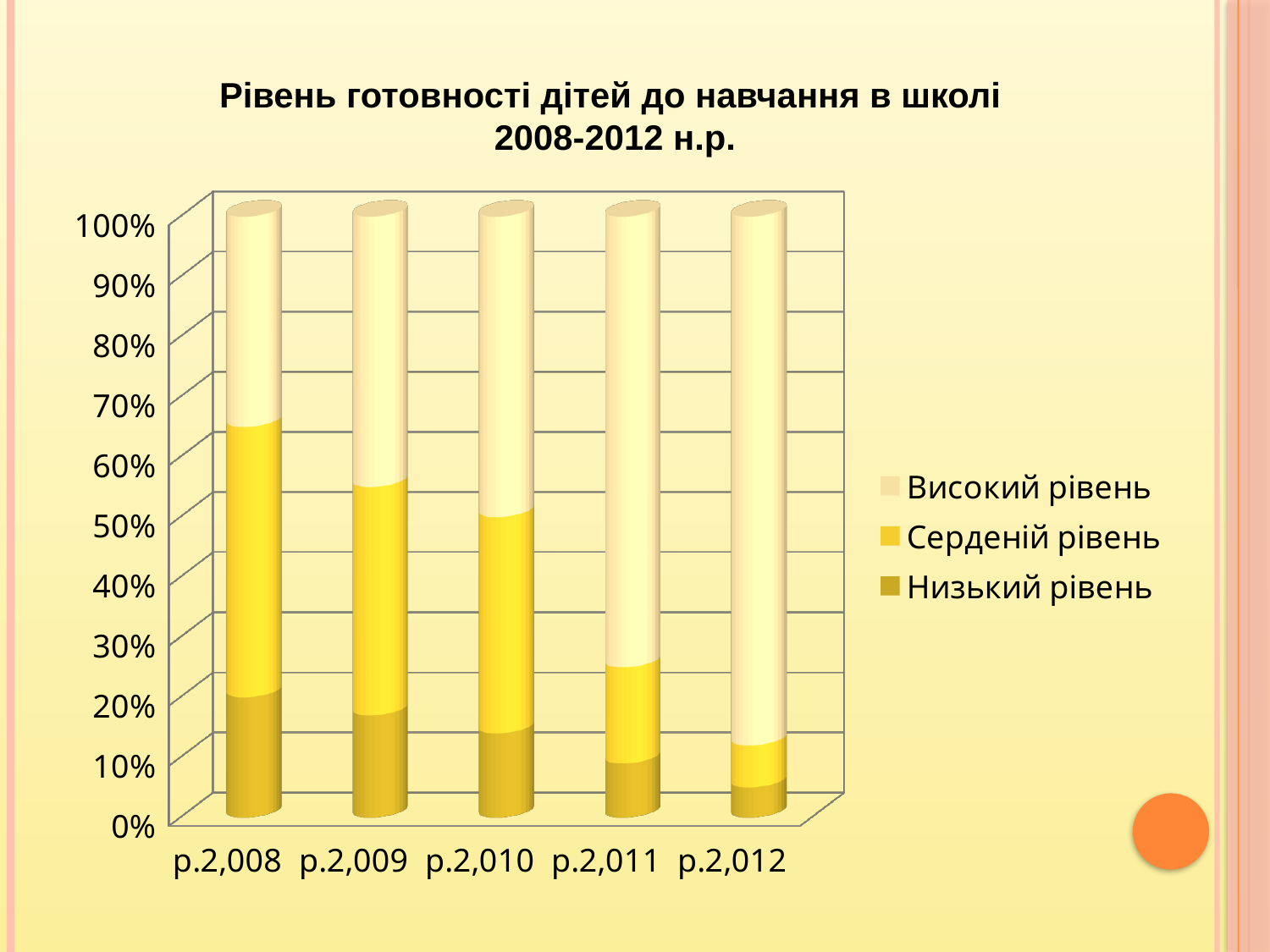
Which year has the larger Високий рівень segment, р.2,010 or р.2,011? р.2,011 Which year has the smallest Низький рівень segment? р.2,012 Which series is listed first in the chart's legend? Високий рівень What kind of chart is shown on the slide? Stacked bar chart How many years (categories) are shown on the x axis of the chart? 5 How many series does the chart's legend list? 3 What is the title of the chart? Рівень готовності дітей до навчання в школі 2008-2012 н.р. Is the Низький рівень value for р.2,008 greater or less than 10%? greater Which year has the largest Низький рівень segment? р.2,008 Is the Високий рівень value for р.2,012 greater or less than 80%? greater Is the Низький рівень value for р.2,012 greater or less than 10%? less Which year has the largest Високий рівень segment? р.2,012